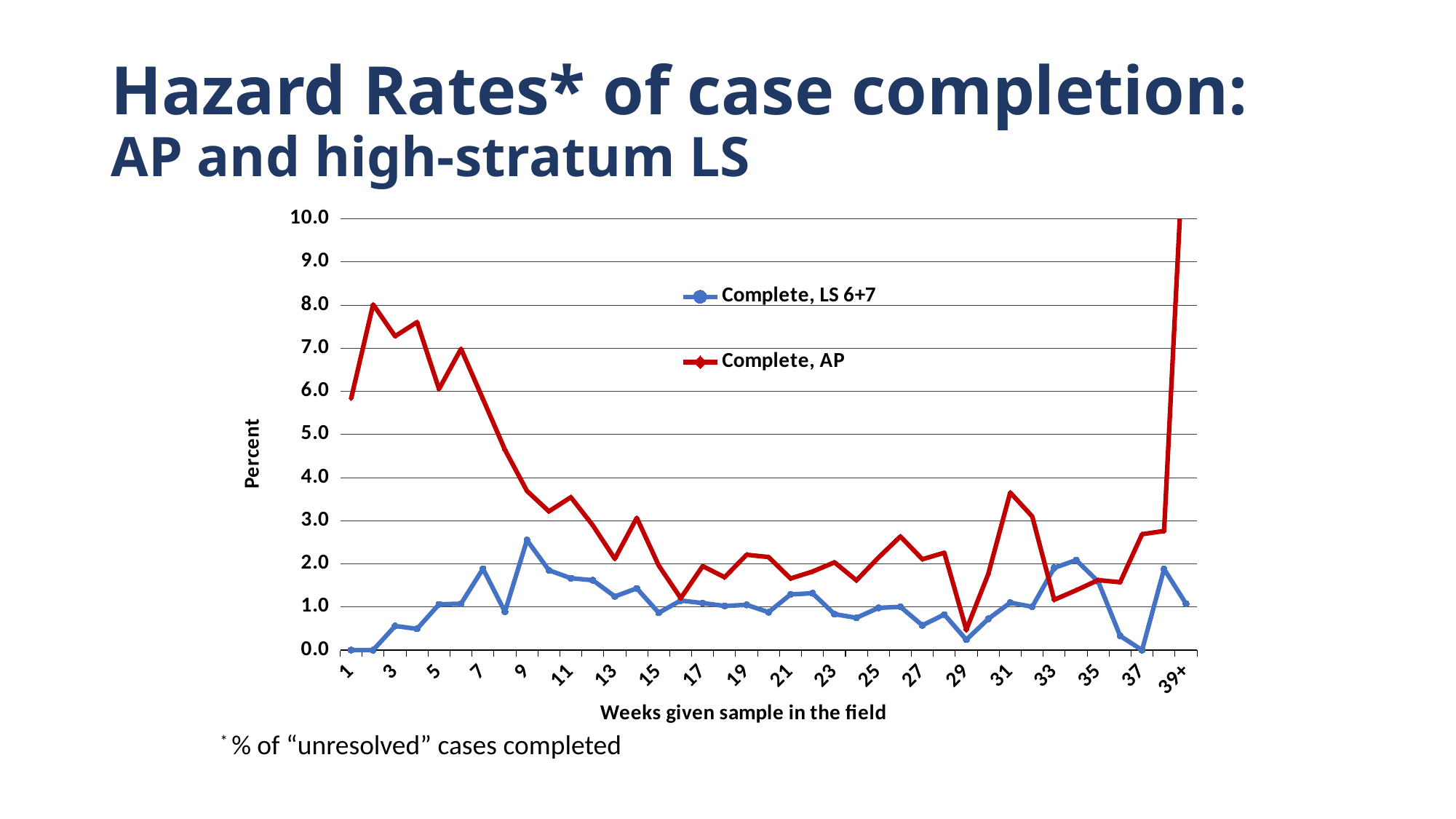
What is the label of the x axis? Weeks given sample in the field What kind of chart is shown on the slide? line chart Is the value for Complete, AP at week 1 greater or less than 5.0? greater At week 9, which series has the larger value, Complete, AP or Complete, LS 6+7? Complete, AP What is the label of the y axis? Percent Is the value for Complete, AP at week 31 greater or less than 3.0? greater What is the value for Complete, LS 6+7 at week 37? 0.0 How many series does the legend list? 2 Is the value for Complete, AP at week 29 greater or less than 1.0? less Does the Complete, AP series rise or fall between week 2 and week 9? fall What is the value for Complete, LS 6+7 at week 1? 0.0